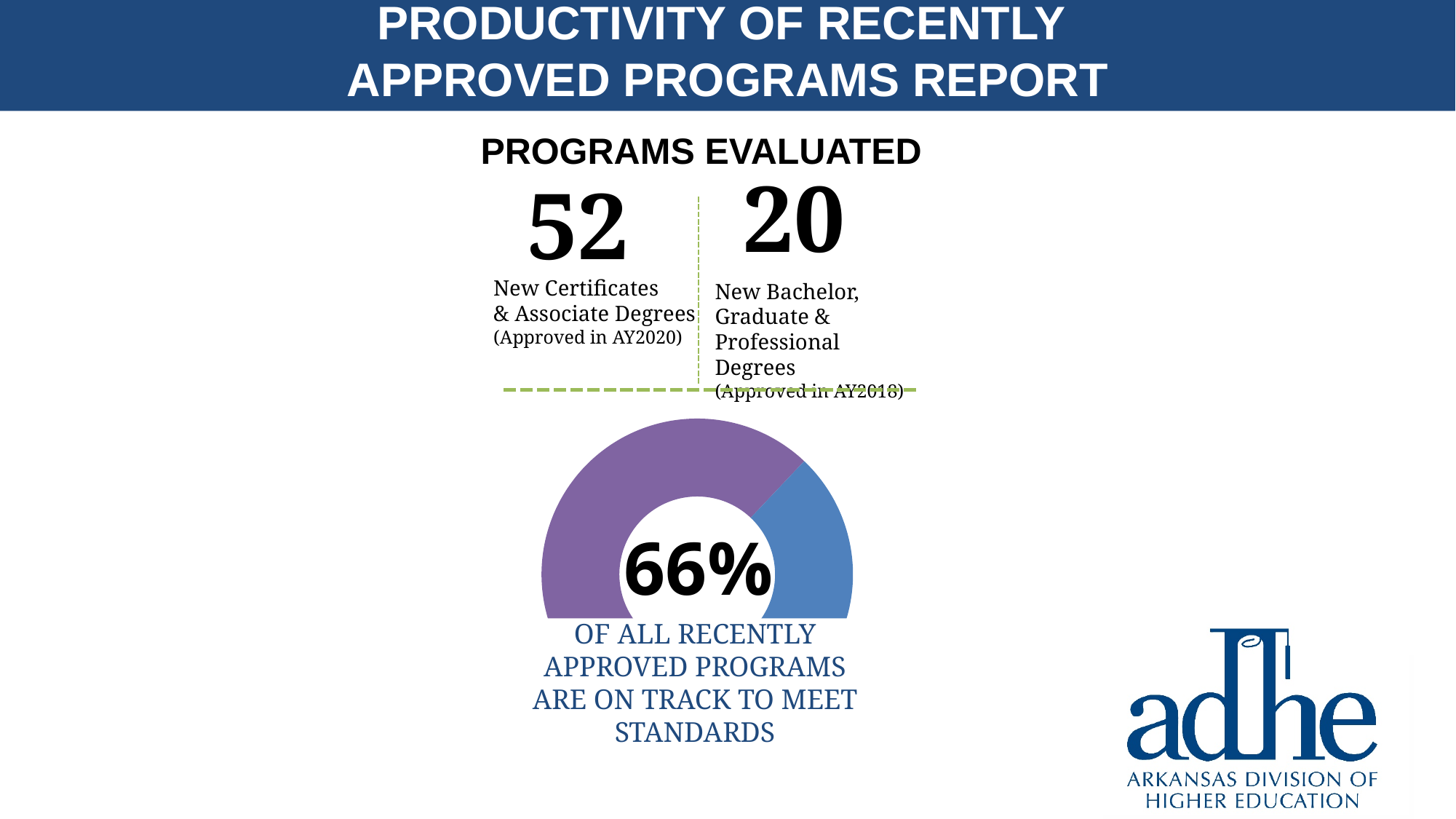
Which segment of the semicircular chart is larger, the purple one or the blue one? Purple What colour is the larger segment of the semicircular chart? Purple According to the text under the semicircular chart, what does the 66% represent? Recently approved programs on track to meet standards How many New Bachelor, Graduate & Professional Degrees were evaluated? 20 Is the purple segment of the semicircular chart greater or less than 50%? greater How many New Certificates & Associate Degrees (approved in AY2020) were evaluated? 52 What kind of chart is shown below the dashed line on the slide? Doughnut (semicircular gauge) chart Is the blue segment of the semicircular chart greater or less than 50%? less What is the difference between the number of New Certificates & Associate Degrees evaluated and the number of New Bachelor, Graduate & Professional Degrees evaluated? 32 How many segments does the semicircular chart have? 2 What share of the semicircular chart does the purple segment represent? 66% What percentage is displayed in the centre of the semicircular chart? 66%